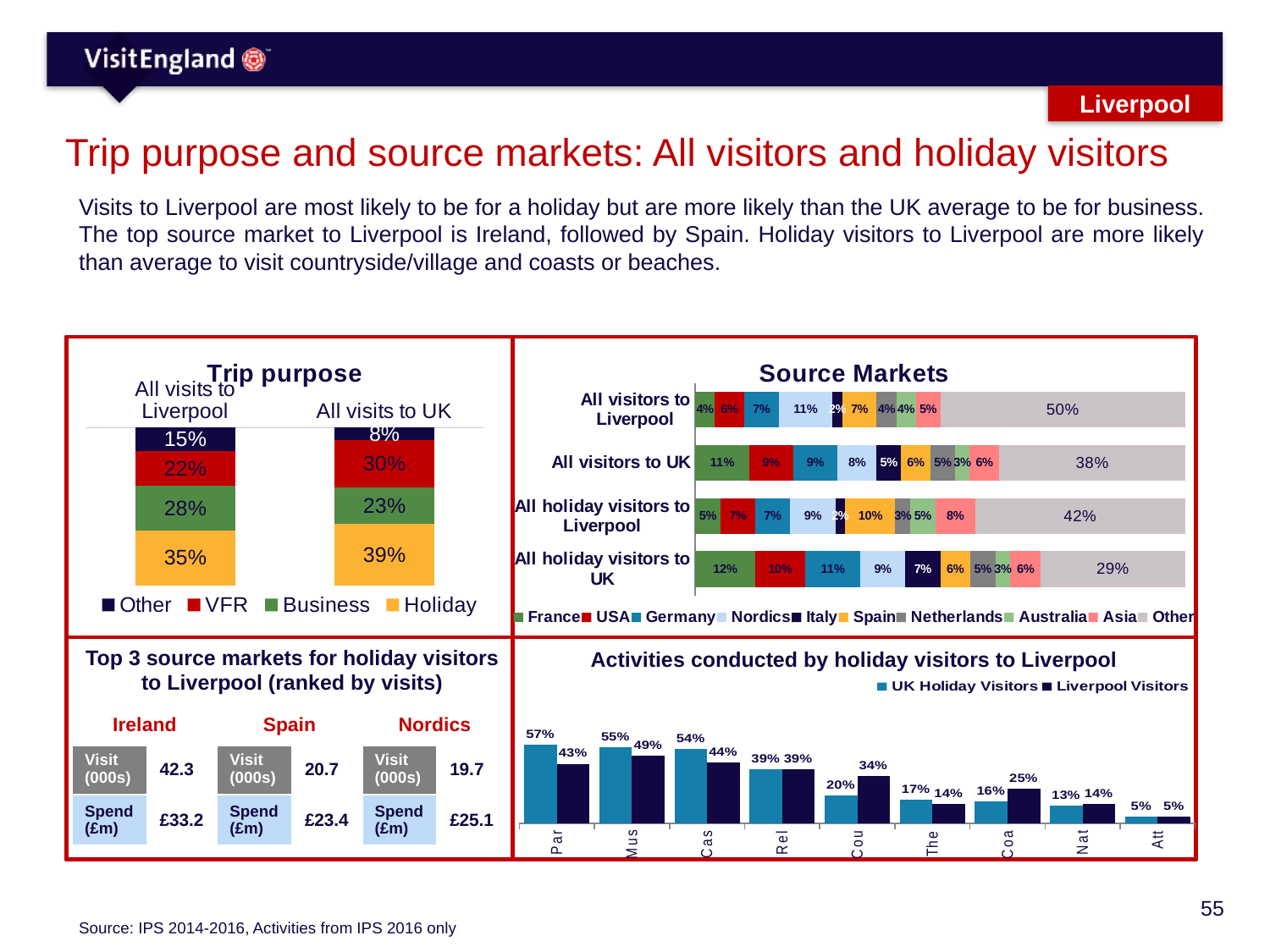
In the Trip purpose chart, what percentage of all visits to Liverpool are for Holiday? 35% In the Source Markets chart, how many source markets does the legend list? 10 In the Top 3 source markets for holiday visitors to Liverpool panel, what is the spend (£m) for Spain? £23.4 In the Trip purpose chart, what is the difference between the Business share for all visits to Liverpool and for all visits to UK? 5 percentage points In the Activities conducted by holiday visitors to Liverpool chart, how many activity categories are shown? 9 In the Source Markets chart, what percentage of all visitors to Liverpool come from the Nordics? 11% In the Activities conducted by holiday visitors to Liverpool chart, what kind of chart is it? Bar chart In the Source Markets chart, what is the 'Other' share for all holiday visitors to Liverpool? 42% In the Activities conducted by holiday visitors to Liverpool chart, which category has the highest value for UK Holiday Visitors? Par In the Trip purpose chart, how many series does the legend list? 4 In the Activities conducted by holiday visitors to Liverpool chart, what is the value for Liverpool Visitors in the 'Cou' category? 34% In the Source Markets chart, which bar has the largest 'Other' share? All visitors to Liverpool